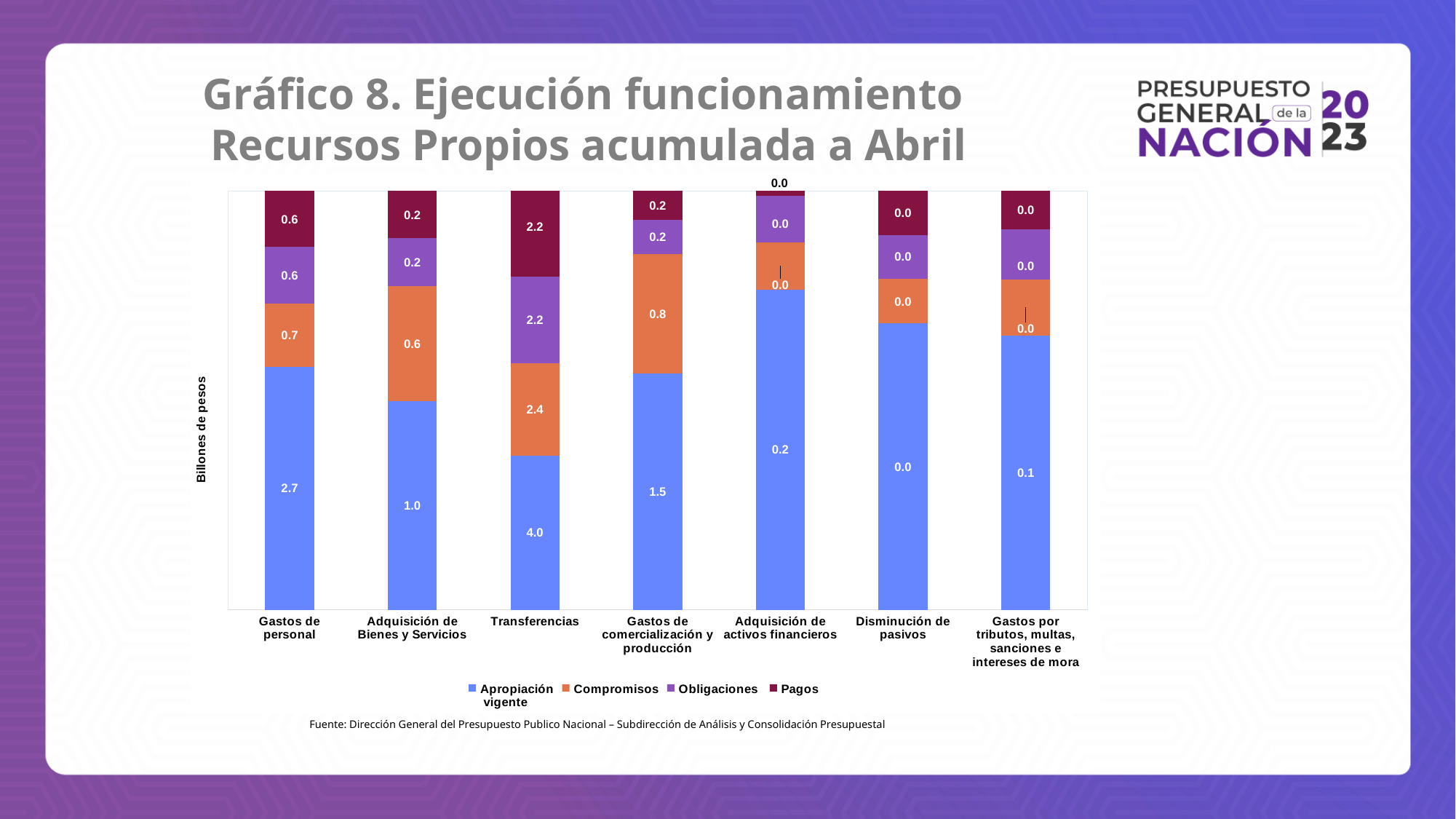
Which category has the highest Compromisos value? Transferencias What is the Obligaciones value for Gastos de comercialización y producción? 0.2 How many series does the legend list? 4 What is the Apropiación vigente value for Transferencias? 4.0 What is the difference between the Apropiación vigente values for Transferencias and Gastos de personal? 1.3 Which category has the highest Apropiación vigente value? Transferencias What is the Compromisos value for Gastos de personal? 0.7 Which is larger, the Compromisos value for Gastos de comercialización y producción or for Adquisición de Bienes y Servicios? Gastos de comercialización y producción How many categories are shown on the x axis? 7 What is the total of the four labelled values in the Gastos de personal bar? 4.6 What kind of chart is shown on the slide? Stacked bar chart What is the Pagos value for Adquisición de Bienes y Servicios? 0.2